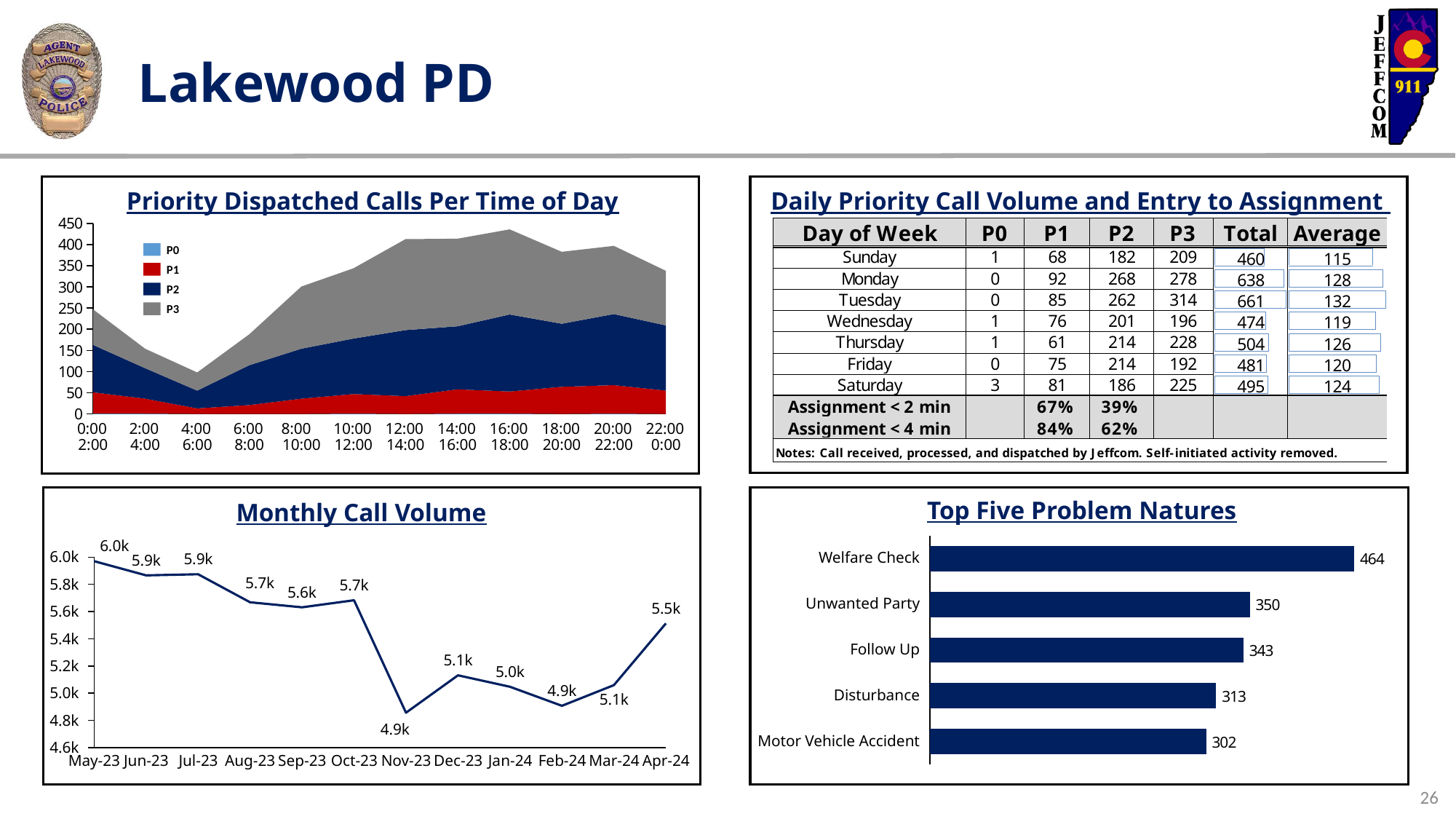
In the Monthly Call Volume chart, is the value for Oct-23 larger or smaller than the value for Nov-23? larger In the Priority Dispatched Calls Per Time of Day chart, is the total stacked value for the 16:00-18:00 period greater or less than 400? greater How many series does the legend of the Priority Dispatched Calls Per Time of Day chart list? 4 In the Top Five Problem Natures chart, which problem nature has the lowest value? Motor Vehicle Accident In the Priority Dispatched Calls Per Time of Day chart, which colour represents P3? grey In the Monthly Call Volume chart, how many months are plotted? 12 In the Monthly Call Volume chart, what is the value for Nov-23? 4.9k What kind of chart is the Top Five Problem Natures chart? bar chart In the Monthly Call Volume chart, what is the value for Apr-24? 5.5k In the Top Five Problem Natures chart, what is the value for Follow Up? 343 In the Monthly Call Volume chart, which month has the highest call volume? May-23 In the Top Five Problem Natures chart, what is the difference between Welfare Check and Unwanted Party? 114